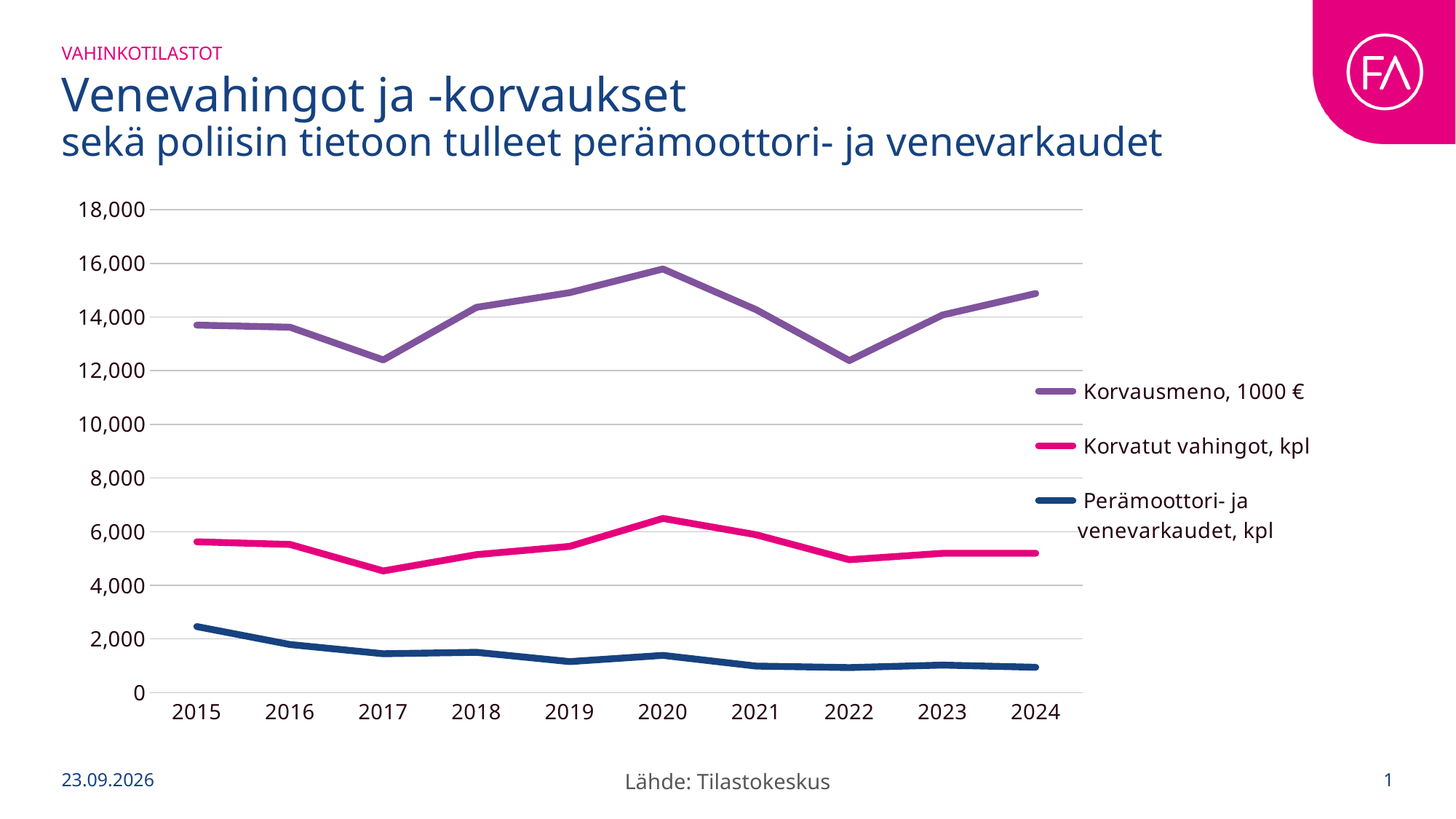
In which year is Perämoottori- ja venevarkaudet, kpl highest? 2015 Which is larger for Korvausmeno, 1000 €: the value in 2020 or the value in 2022? 2020 How many series does the legend list? 3 Is the value for Korvausmeno, 1000 € in 2020 greater or less than 14,000? greater Is the value for Perämoottori- ja venevarkaudet, kpl in 2024 greater or less than 2,000? less In which year is Korvausmeno, 1000 € highest? 2020 What kind of chart is shown on the slide? line chart How many years are shown on the x axis? 10 Is the value for Korvatut vahingot, kpl in 2020 greater or less than 6,000? greater Does Perämoottori- ja venevarkaudet, kpl rise or fall overall from 2015 to 2024? fall In which year is Korvatut vahingot, kpl highest? 2020 In which year is Korvatut vahingot, kpl lowest? 2017